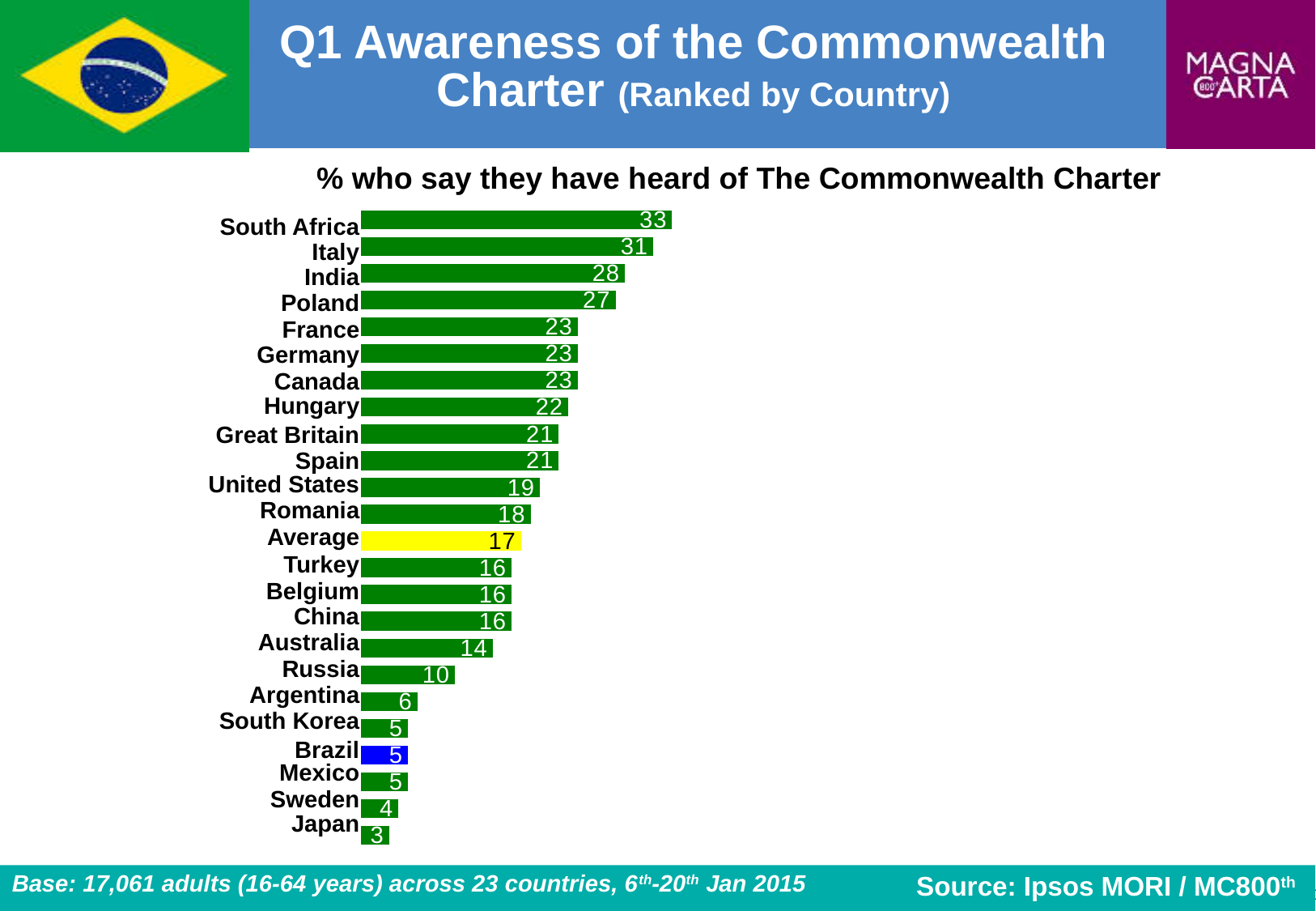
What is the value for Brazil? 5 Which has a larger value, Poland or Hungary? Poland What is the value shown for Average? 17 What kind of chart is shown on the slide? Bar chart What is the value for South Africa? 33 What is the difference between the values for South Africa and Italy? 2 Which country has the highest value? South Africa What is the difference between the values for India and Brazil? 23 What is the value for Russia? 10 Which country has the lowest value? Japan What colour is the Brazil bar? Blue How many bars are plotted in the chart, including the Average bar? 24